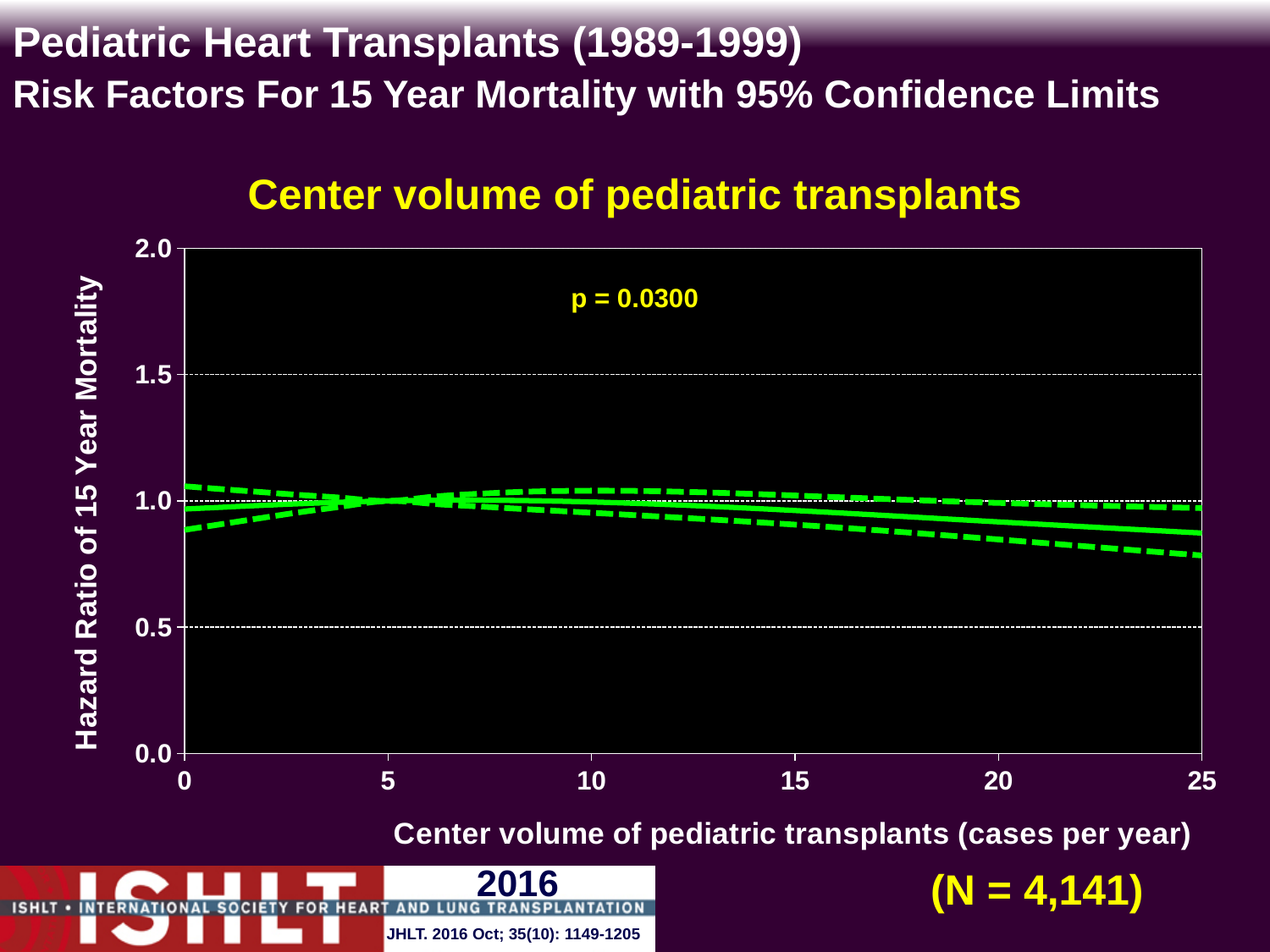
What is the title of the chart? Center volume of pediatric transplants What is the maximum value shown on the y axis of the chart? 2.0 Does the solid hazard ratio line rise or fall as center volume increases from 0 to 25 cases per year? fall Is the hazard ratio (solid line) at a center volume of 25 cases per year greater or less than 1.0? less What kind of chart is shown on the slide? line chart Is the lower 95% confidence limit (lower dashed line) at a center volume of 25 cases per year greater or less than 1.0? less Is the upper 95% confidence limit (upper dashed line) at a center volume of 0 cases per year greater or less than 1.5? less What p-value is printed on the chart? p = 0.0300